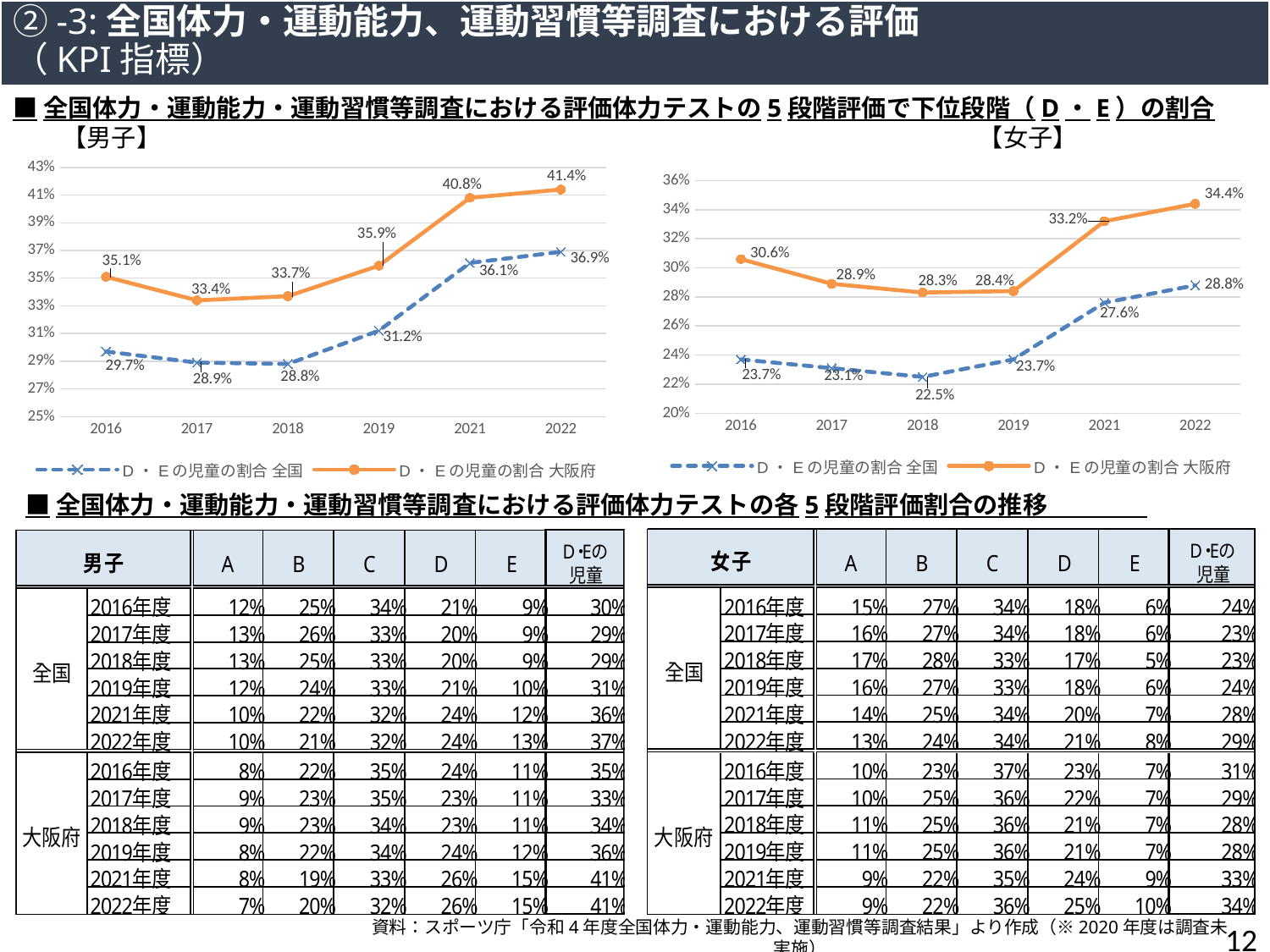
What kind of chart is the 【男子】 chart? Line chart In the 【女子】 chart, in which year is the 全国 value lowest? 2018 How many years are plotted on the x axis of the 【男子】 chart? 6 In the 【女子】 chart, what is the difference between the 大阪府 values in 2022 and 2016? 3.8% In the 【男子】 chart, in which year is the 大阪府 value lowest? 2017 In the 【男子】 chart, what is the value for 全国 in 2018? 28.8% In the 【女子】 chart, what is the value for 全国 in 2021? 27.6% In the 【女子】 chart, which is larger in 2019: the 大阪府 value or the 全国 value? 大阪府 In the 【女子】 chart, what is the value for 大阪府 in 2016? 30.6% How many series does the legend of the 【女子】 chart list? 2 In the 【男子】 chart, what is the value for 大阪府 in 2022? 41.4% In the 【男子】 chart, what is the difference between the 大阪府 and 全国 values in 2022? 4.5%